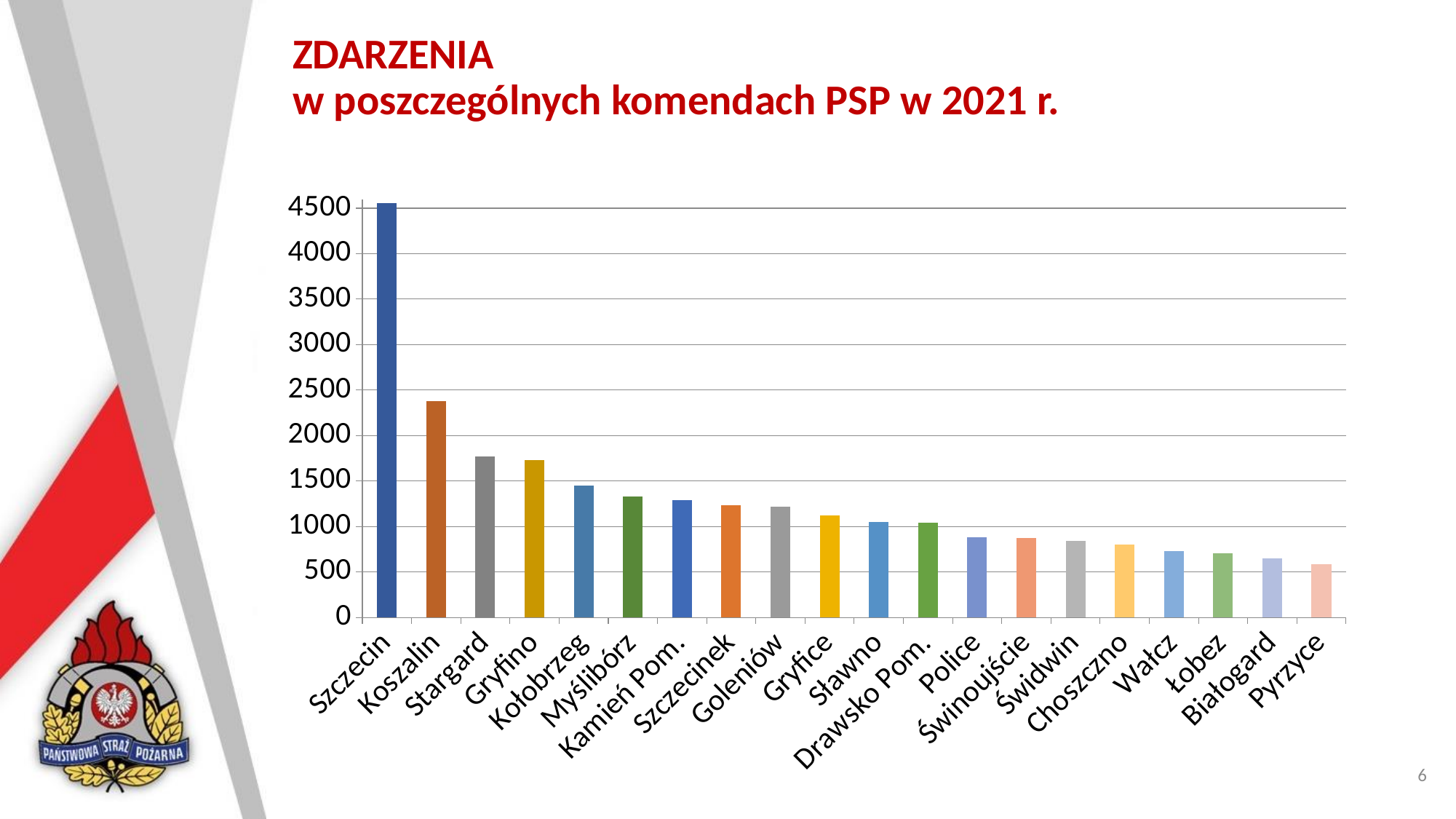
Which command has the lowest number of incidents in the chart? Pyrzyce Is the value for Szczecin greater or less than 4000? greater Is the value for Pyrzyce greater or less than 500? greater Do the values rise or fall moving from left to right along the x axis? fall What is the title of the slide containing the chart? ZDARZENIA w poszczególnych komendach PSP w 2021 r. What kind of chart is shown on the slide? bar chart How many commands (categories) are shown on the x axis of the chart? 20 Is the value for Police greater or less than 1000? less Which command has the highest number of incidents in the chart? Szczecin Which has a larger value, Koszalin or Stargard? Koszalin